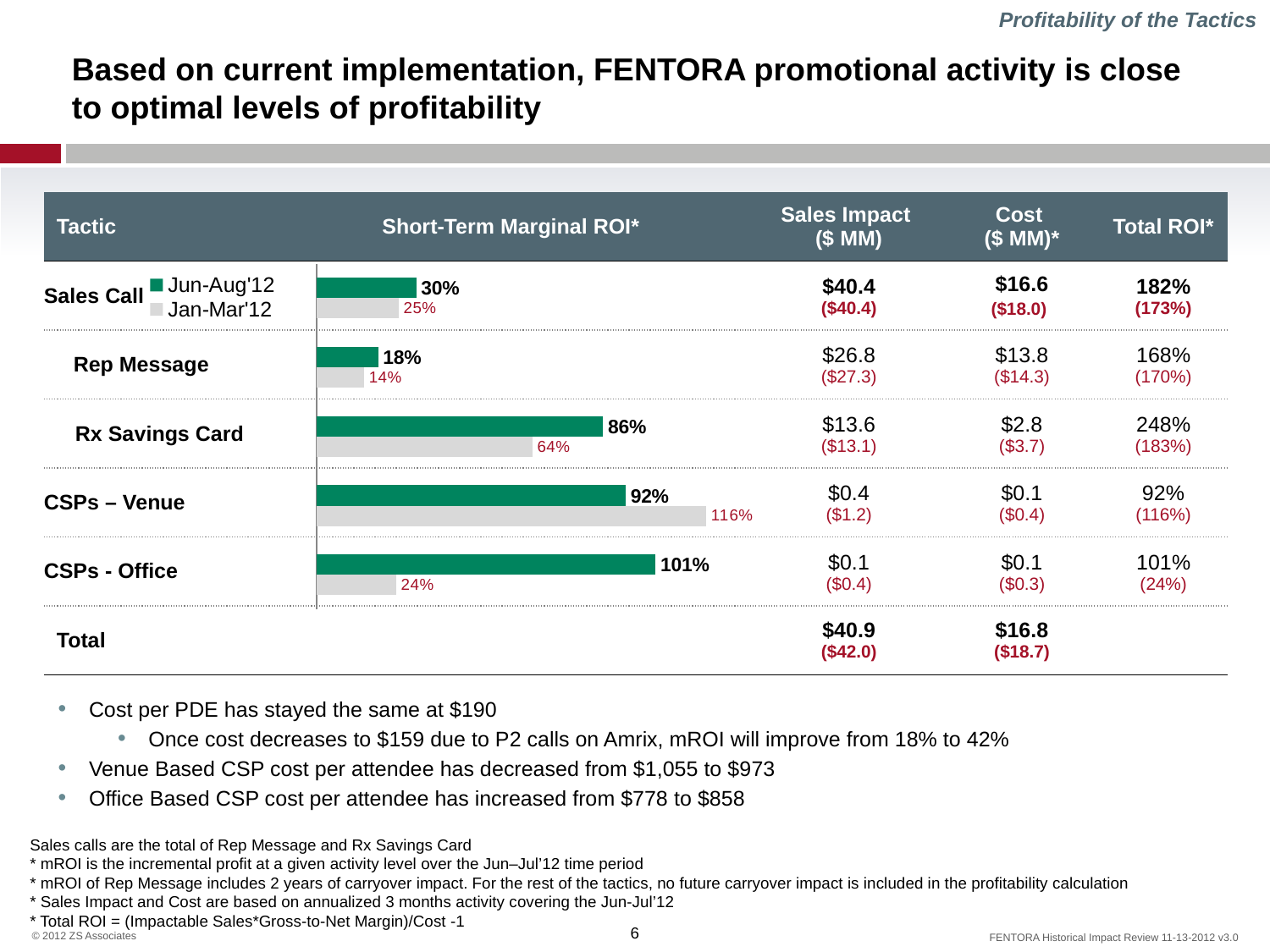
What is the difference between the Jun-Aug'12 and Jan-Mar'12 Short-Term Marginal ROI for Rx Savings Card? 22% What is the Short-Term Marginal ROI for Rx Savings Card in Jun-Aug'12? 86% Which tactic has the highest Short-Term Marginal ROI for Jun-Aug'12? CSPs - Office What kind of chart is used to show Short-Term Marginal ROI? Bar chart Which tactic has the lowest Short-Term Marginal ROI for Jan-Mar'12? Rep Message How many series does the legend of the Short-Term Marginal ROI chart list? 2 What is the Short-Term Marginal ROI for Rep Message in Jun-Aug'12? 18% What is the Short-Term Marginal ROI for CSPs – Venue in Jan-Mar'12? 116% What is the difference between the Jun-Aug'12 and Jan-Mar'12 Short-Term Marginal ROI for CSPs - Office? 77% For CSPs – Venue, which period has the larger Short-Term Marginal ROI, Jun-Aug'12 or Jan-Mar'12? Jan-Mar'12 How many tactics are plotted in the Short-Term Marginal ROI bar chart? 5 Which colour represents the Jun-Aug'12 series in the Short-Term Marginal ROI chart? Green